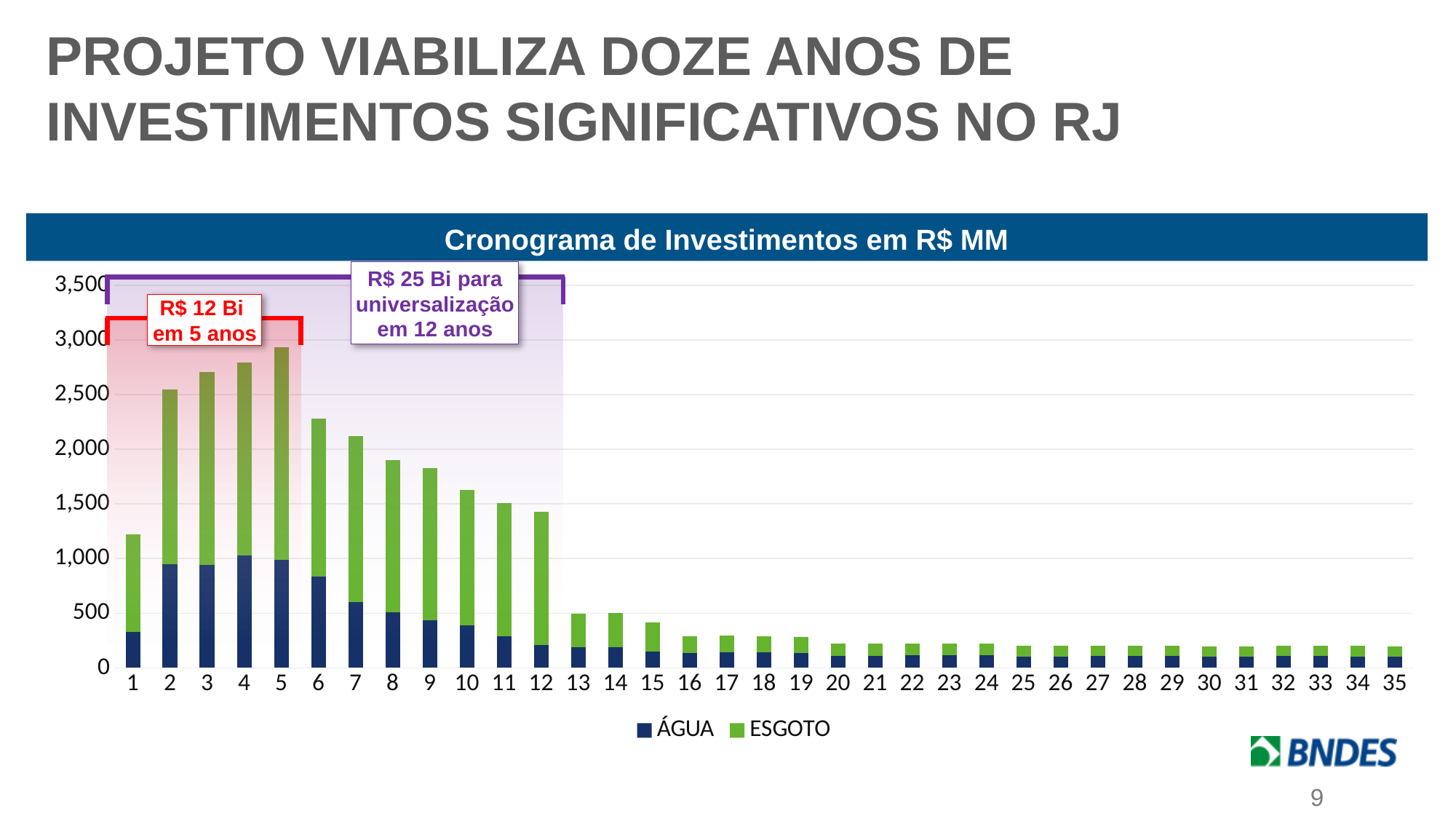
Is the total bar for year 6 greater or less than 2,000? greater What kind of chart is shown on the slide? Stacked bar chart Which year has the highest total investment? 5 What is the title of the chart? Cronograma de Investimentos em R$ MM Which has a larger total investment, year 2 or year 1? Year 2 How many categories (years) are shown on the x axis? 35 From year 5 onward, do the total investment values rise or fall along the x axis? Fall Is the total bar for year 1 greater or less than 1,000? greater Is the total bar for year 10 greater or less than 1,500? greater How many series does the legend list? 2 Which two series are listed in the legend? ÁGUA and ESGOTO